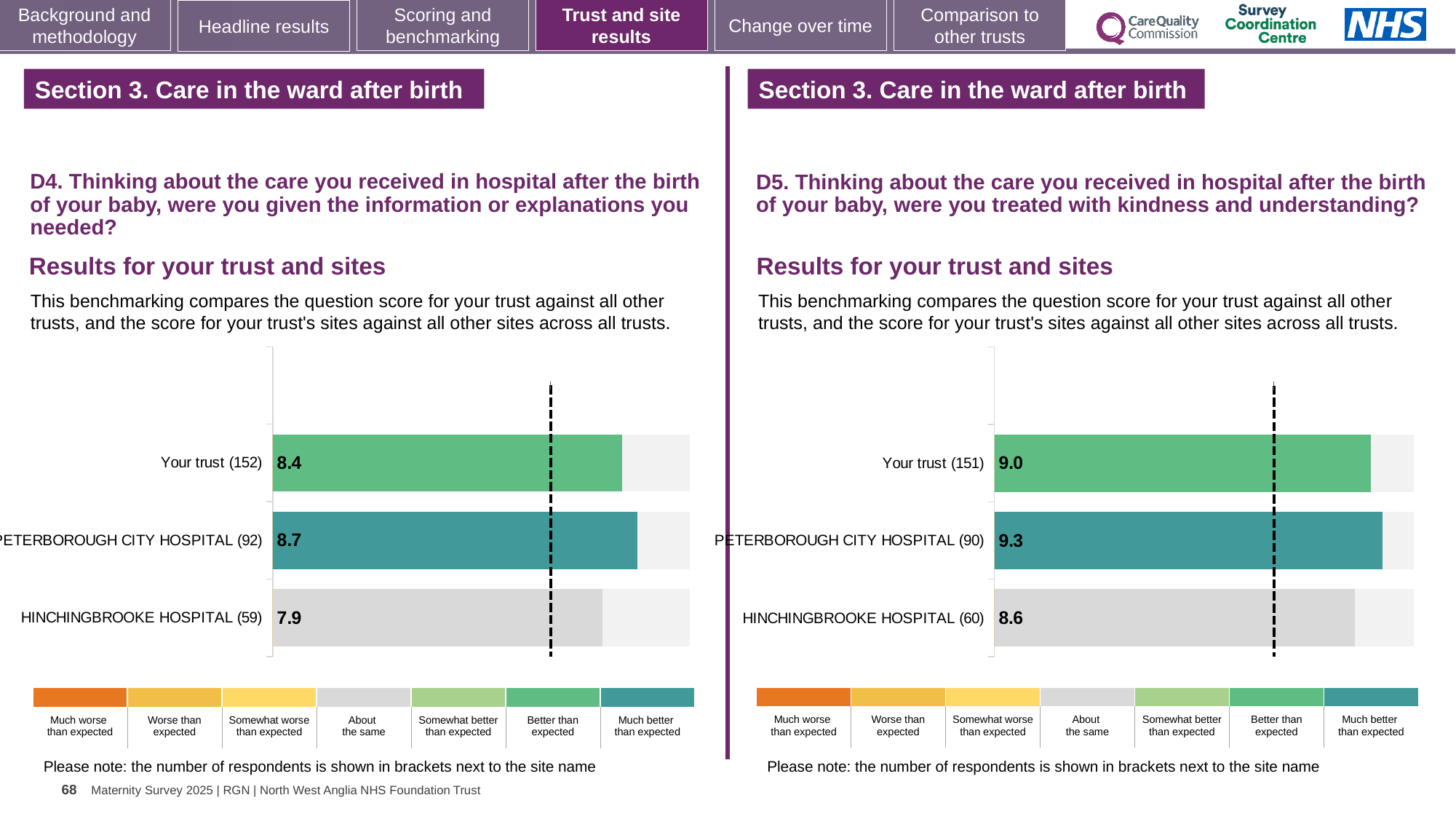
In the D5 chart on the right, what is the score for Your trust? 9.0 In the D4 chart on the left, what is the score for HINCHINGBROOKE HOSPITAL? 7.9 What type of chart is used in the D5 chart on the right? Bar chart In the D5 chart on the right, what is the score for HINCHINGBROOKE HOSPITAL? 8.6 In the D5 chart on the right, which site or trust has the highest score? PETERBOROUGH CITY HOSPITAL In the D4 chart on the left, which site or trust has the lowest score? HINCHINGBROOKE HOSPITAL In the D4 chart on the left, what is the score for Your trust? 8.4 In the D5 chart on the right, which has the larger score, Your trust or HINCHINGBROOKE HOSPITAL? Your trust How many bars are plotted in the D4 chart on the left? 3 In the D4 chart on the left, what is the score for PETERBOROUGH CITY HOSPITAL? 8.7 In the D5 chart on the right, what is the difference between the scores for PETERBOROUGH CITY HOSPITAL and Your trust? 0.3 In the D4 chart on the left, what is the difference between the scores for PETERBOROUGH CITY HOSPITAL and HINCHINGBROOKE HOSPITAL? 0.8